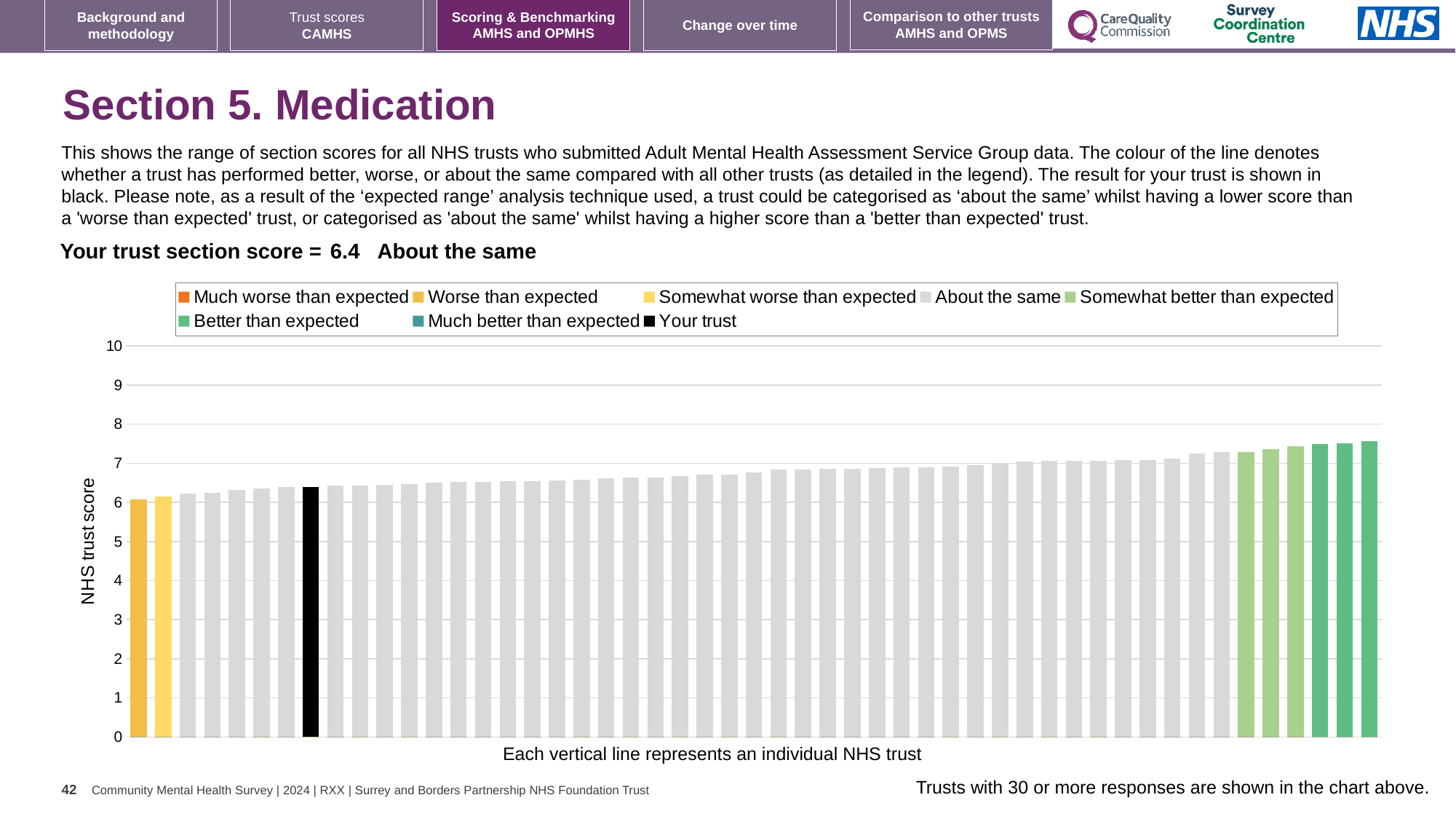
Which category does the slide say your trust's section score falls into? About the same What is the section score for your trust, as printed on the slide? 6.4 Is the value of the black 'Your trust' bar greater or less than 6? greater Is the value of the tallest bar in the chart greater or less than 8? less How many bars are coloured in the 'Worse than expected' colour? 1 Is the value of the tallest bar in the chart greater or less than 7? greater How many entries does the chart legend list? 8 Do the bar values rise or fall moving from left to right along the x axis? rise What kind of chart is shown on the slide? bar chart How many bars are coloured in the 'Better than expected' colour? 3 What is the label on the vertical axis of the chart? NHS trust score